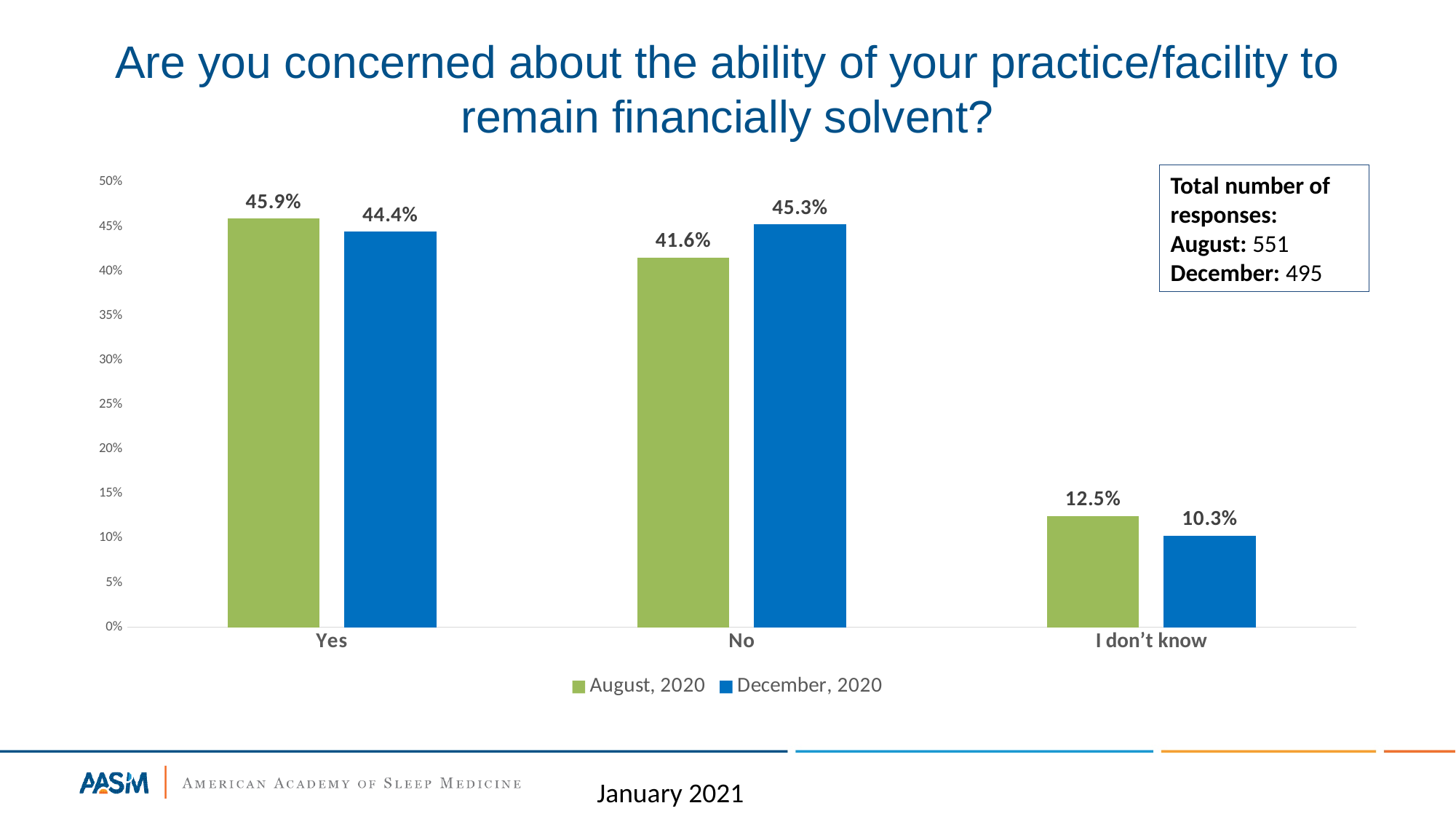
Which colour represents the December, 2020 series? Blue What kind of chart is shown on the slide? Bar chart What is the difference between the August, 2020 and December, 2020 values for "No"? 3.7% How many response categories are shown on the x axis? 3 How many series does the legend list? 2 What is the value for "I don't know" in December, 2020? 10.3% For the "Yes" category, which series has the larger value: August, 2020 or December, 2020? August, 2020 Which response category has the highest value for December, 2020? No What percentage of respondents answered "Yes" in August, 2020? 45.9% What is the difference between the August, 2020 and December, 2020 values for "I don't know"? 2.2% Which response category has the lowest value for August, 2020? I don't know What percentage of respondents answered "No" in December, 2020? 45.3%